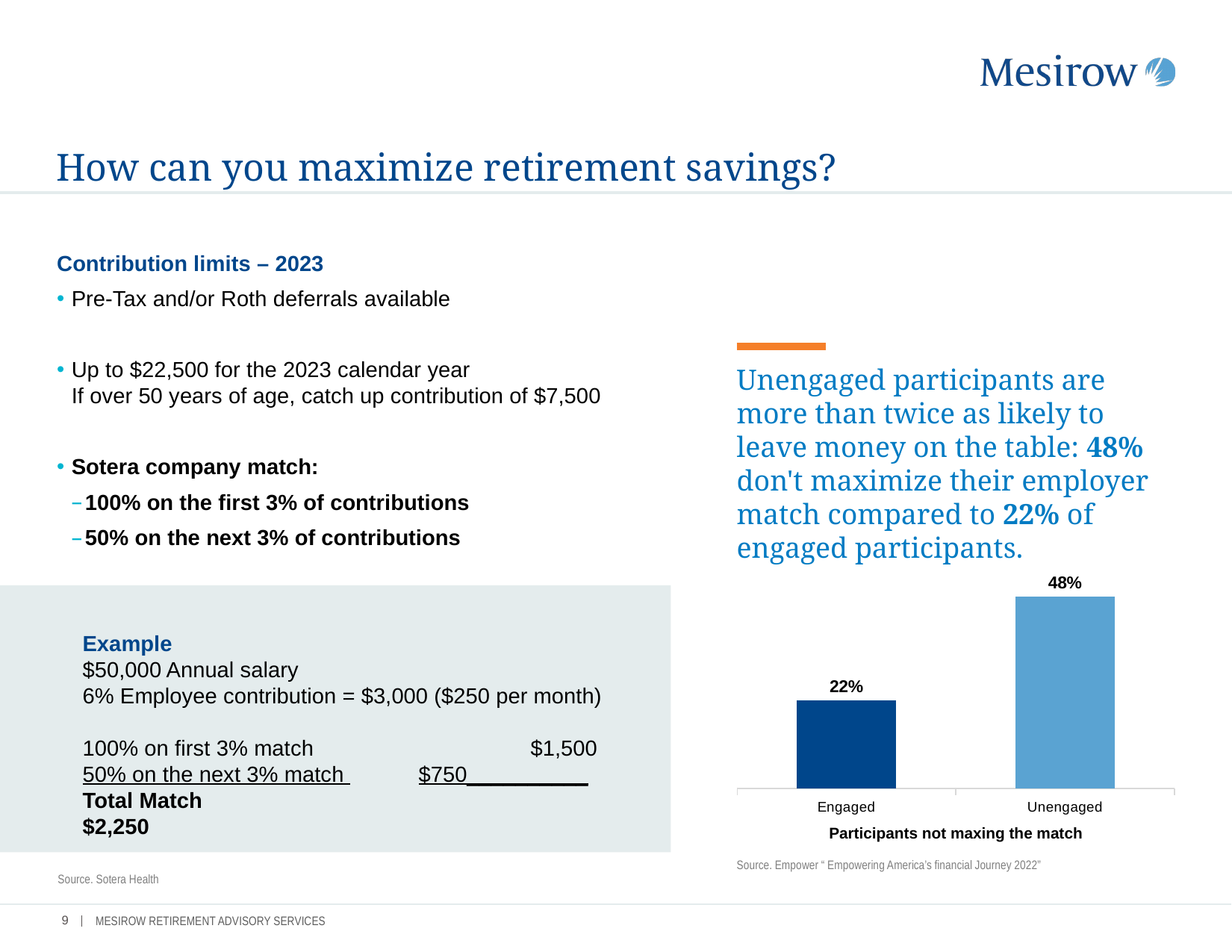
What is the difference between the Unengaged and Engaged values in the chart? 26% What is the title shown below the chart's x axis? Participants not maxing the match Which is larger in the chart, the value for Engaged or for Unengaged? Unengaged What is the value for Engaged participants in the chart? 22% Which category has the lowest value in the chart? Engaged What kind of chart is shown on the slide? Bar chart What is the value for Unengaged participants in the chart? 48% Which bar in the chart is the darker blue? Engaged Which category has the highest value in the chart? Unengaged How many categories are shown in the chart? 2